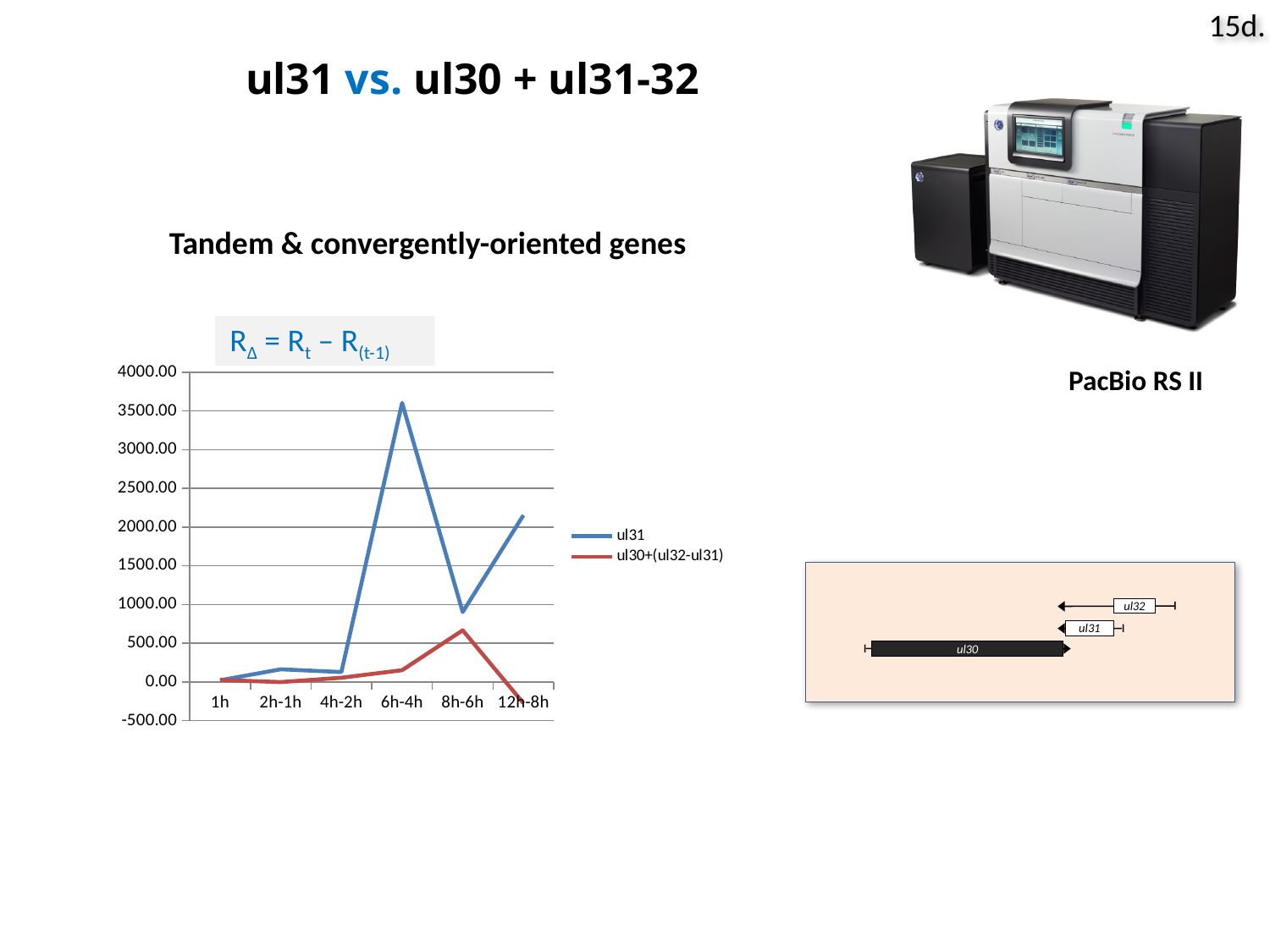
Is the value of ul30+(ul32-ul31) at 12h-8h greater or less than 0.00? less Is the value of ul30+(ul32-ul31) at 8h-6h greater or less than 500.00? greater How many series does the chart's legend list? 2 At which x-axis category does the ul30+(ul32-ul31) series reach its highest value? 8h-6h What kind of chart is shown on the slide? line chart At 6h-4h, which series has the higher value, ul31 or ul30+(ul32-ul31)? ul31 Is the value of ul31 at 12h-8h greater or less than 2500.00? less What colour is the line for the ul31 series? blue How many categories are shown along the x axis of the chart? 6 At which x-axis category does the ul31 series reach its highest value? 6h-4h Does the ul31 series rise or fall between 4h-2h and 6h-4h? rise